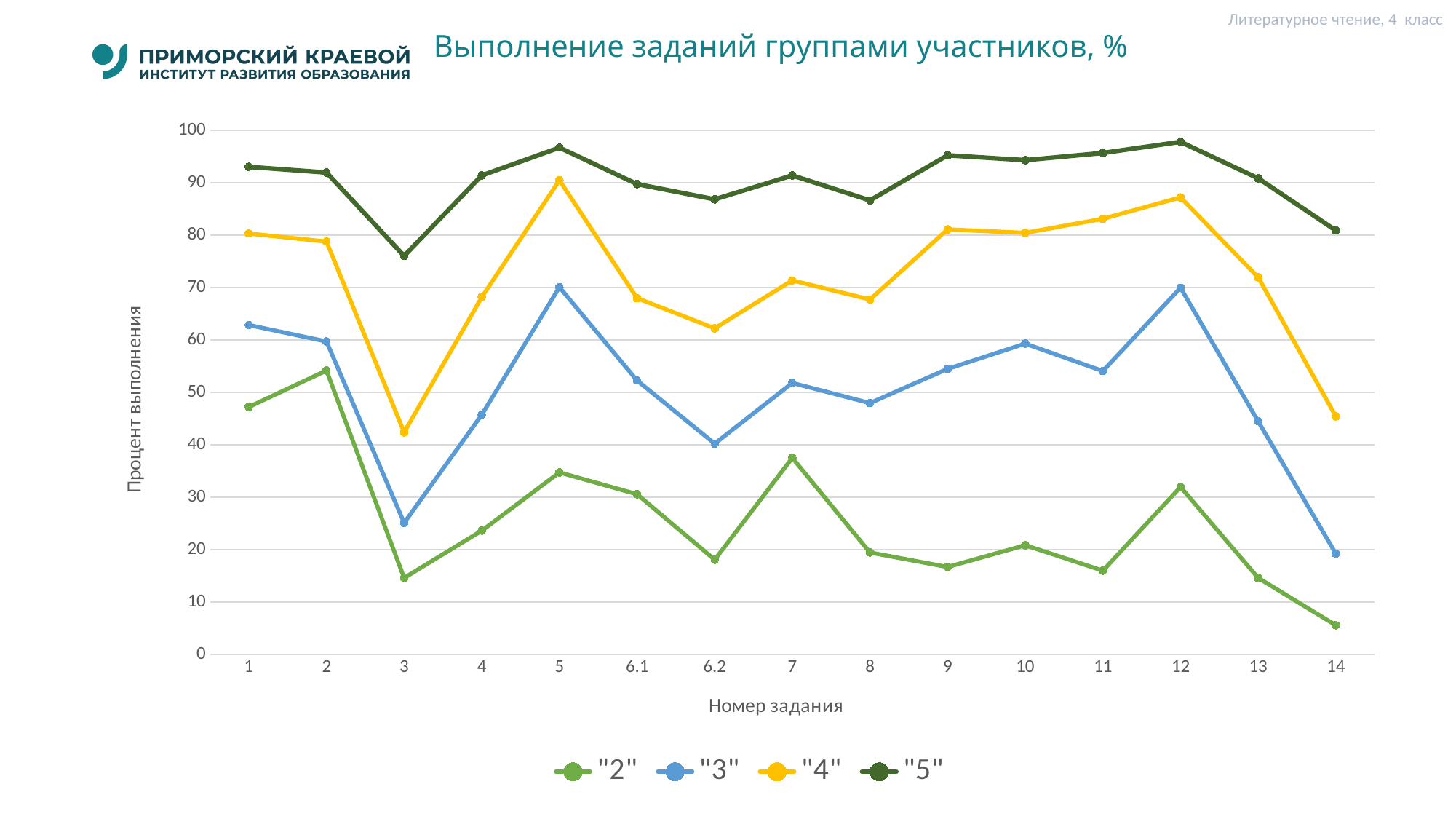
For series "3", which is larger: the value at task 10 or the value at task 11? task 10 How many series does the legend list? 4 Is the value for series "2" at task 1 greater or less than 50? less How many task numbers are plotted along the x axis? 15 Is the value for series "4" at task 14 greater or less than 50? less Is the value for series "3" at task 3 greater or less than 30? less What is the title of the chart? Выполнение заданий группами участников, % For which task number is the value of series "2" lowest? 14 For which task number is the value of series "5" lowest? 3 Does the value of series "2" rise or fall from task 12 to task 14? fall For which task number is the value of series "4" highest? 5 What kind of chart is shown on the slide? line chart